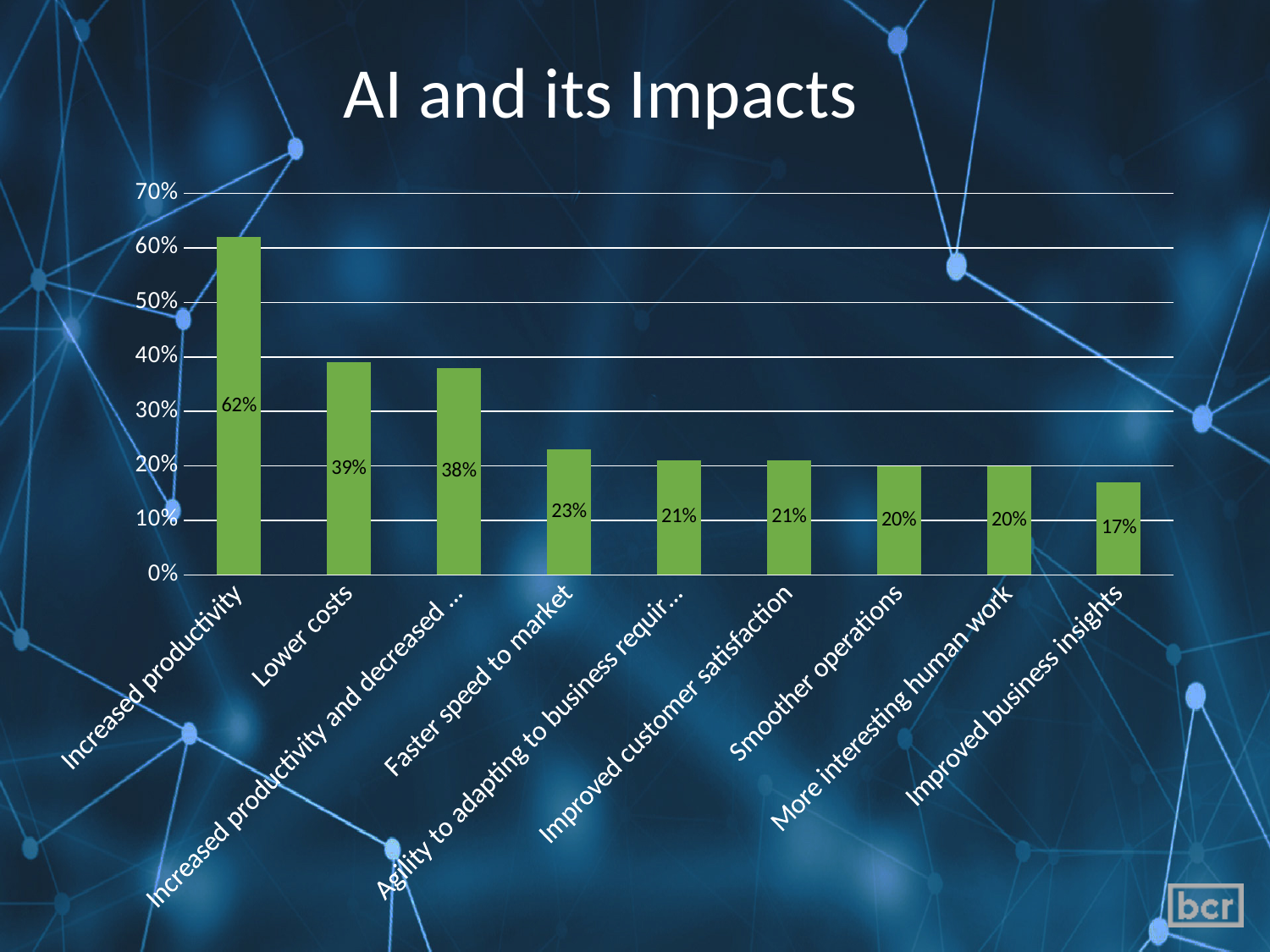
What is the value for Increased productivity? 62% What is the value for Lower costs? 39% What is the difference between the values for Increased productivity and Lower costs? 23% What is the value for Improved business insights? 17% What is the title of the slide? AI and its Impacts What kind of chart is shown on the slide? Bar chart What is the value for Faster speed to market? 23% Which category has the highest value? Increased productivity How many categories are shown in the chart? 9 Which is larger, the value for Faster speed to market or the value for Smoother operations? Faster speed to market Do the values rise or fall from left to right along the x axis? Fall Which category has the lowest value? Improved business insights